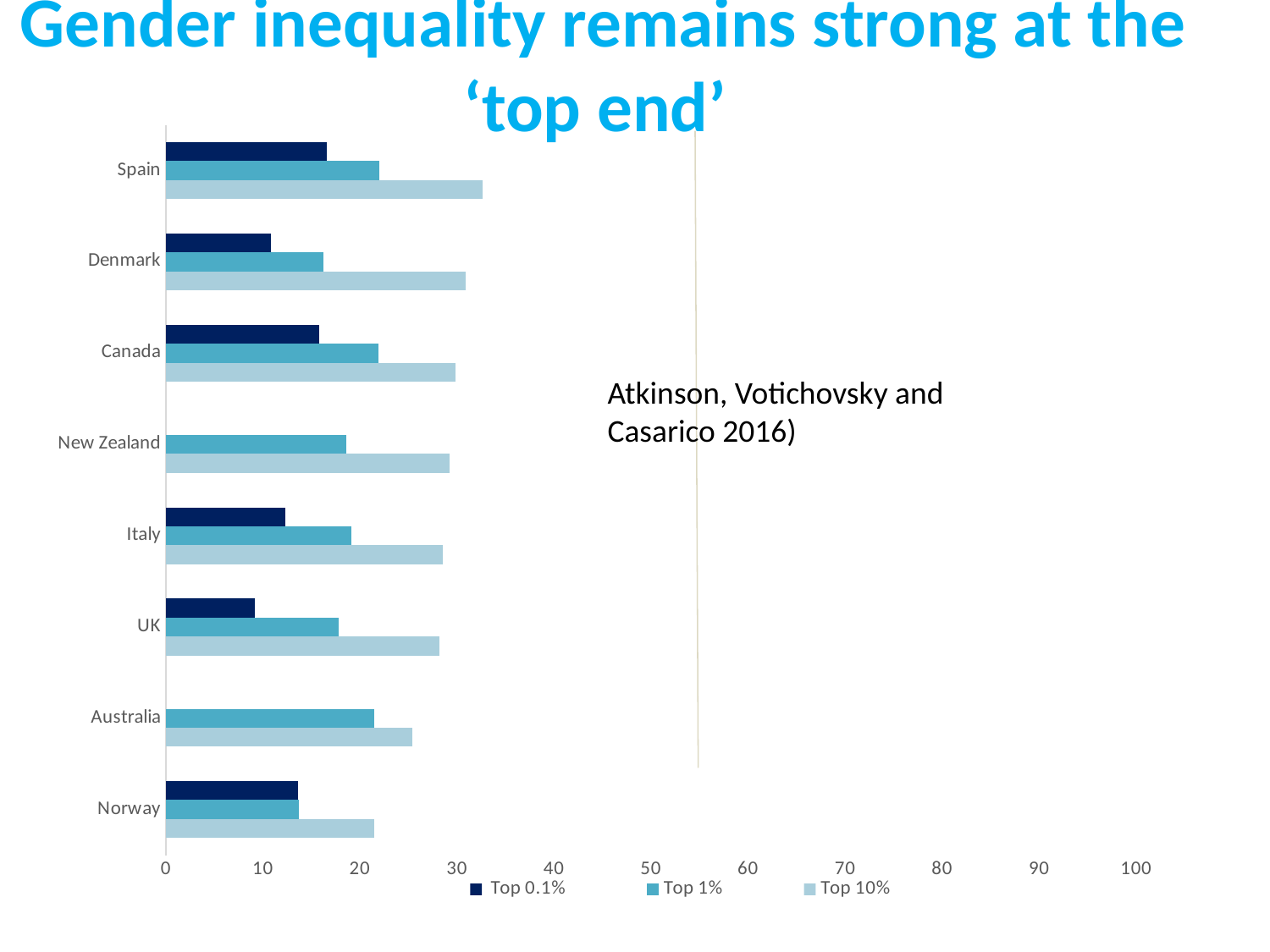
Which is larger, the Top 10% value for Spain or the Top 10% value for Norway? Spain Is the Top 10% value for Australia greater or less than 30? less Is the Top 0.1% value for the UK greater or less than 10? less How many countries are listed on the chart? 8 What kind of chart is shown on the slide? bar chart Which country has the lowest Top 10% value? Norway Which country has the lowest Top 0.1% value among those with a Top 0.1% bar? UK Is the Top 1% value for Denmark greater or less than 20? less How many series does the legend list? 3 What are the three series named in the legend? Top 0.1%, Top 1%, Top 10%